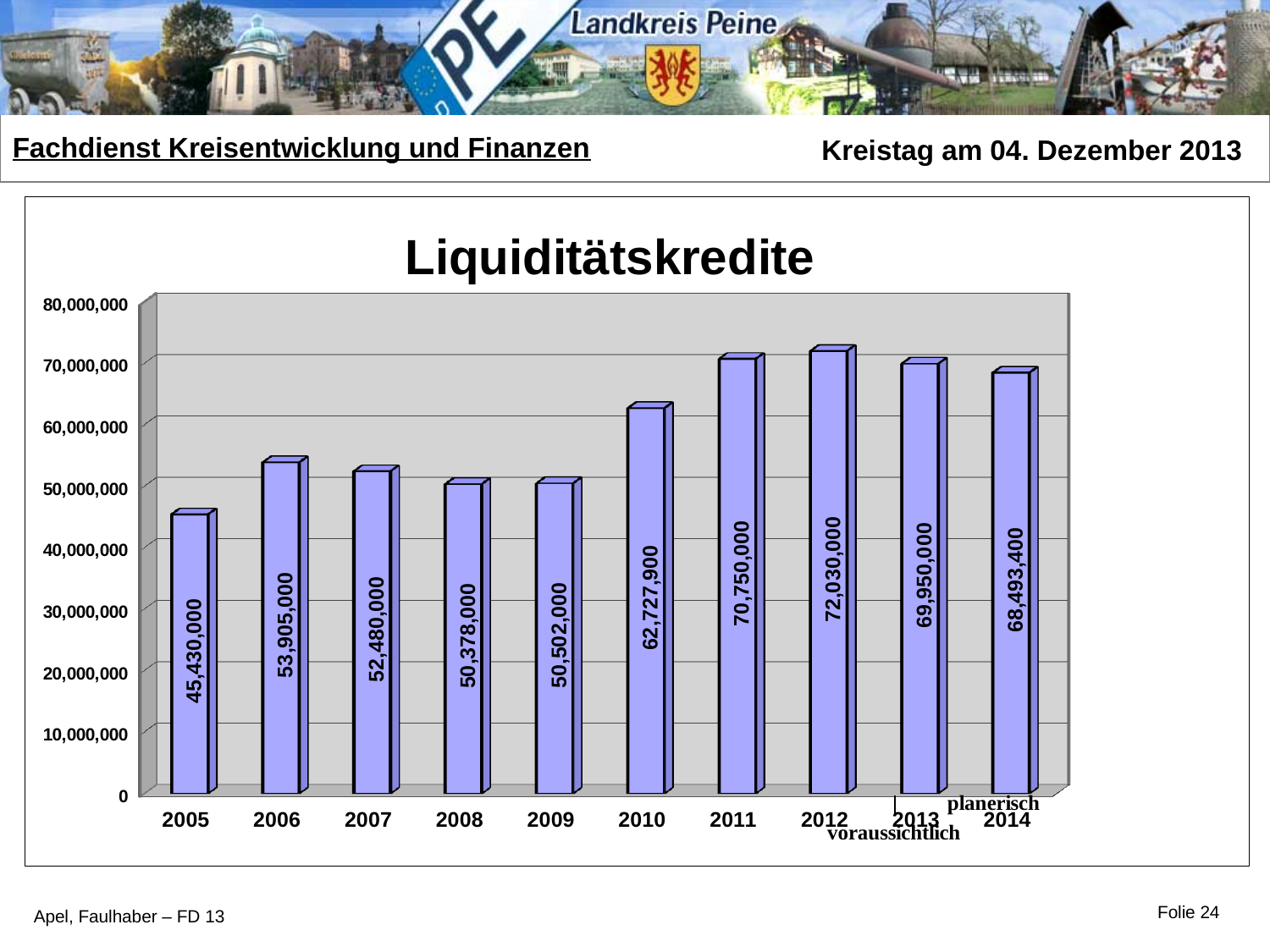
What is the value for 2014? 68,493,400 What is the value for 2010? 62,727,900 Which year has the highest value? 2012 What is the title of the chart? Liquiditätskredite Which is larger, the value for 2013 or the value for 2014? 2013 How many years are shown on the x axis? 10 What is the difference between the values for 2011 and 2010? 8,022,100 Which year has the lowest value? 2005 Is the value for 2010 greater or less than 60,000,000? greater What is the difference between the values for 2012 and 2005? 26,600,000 What type of chart is shown on the slide? bar chart What is the value for 2005? 45,430,000